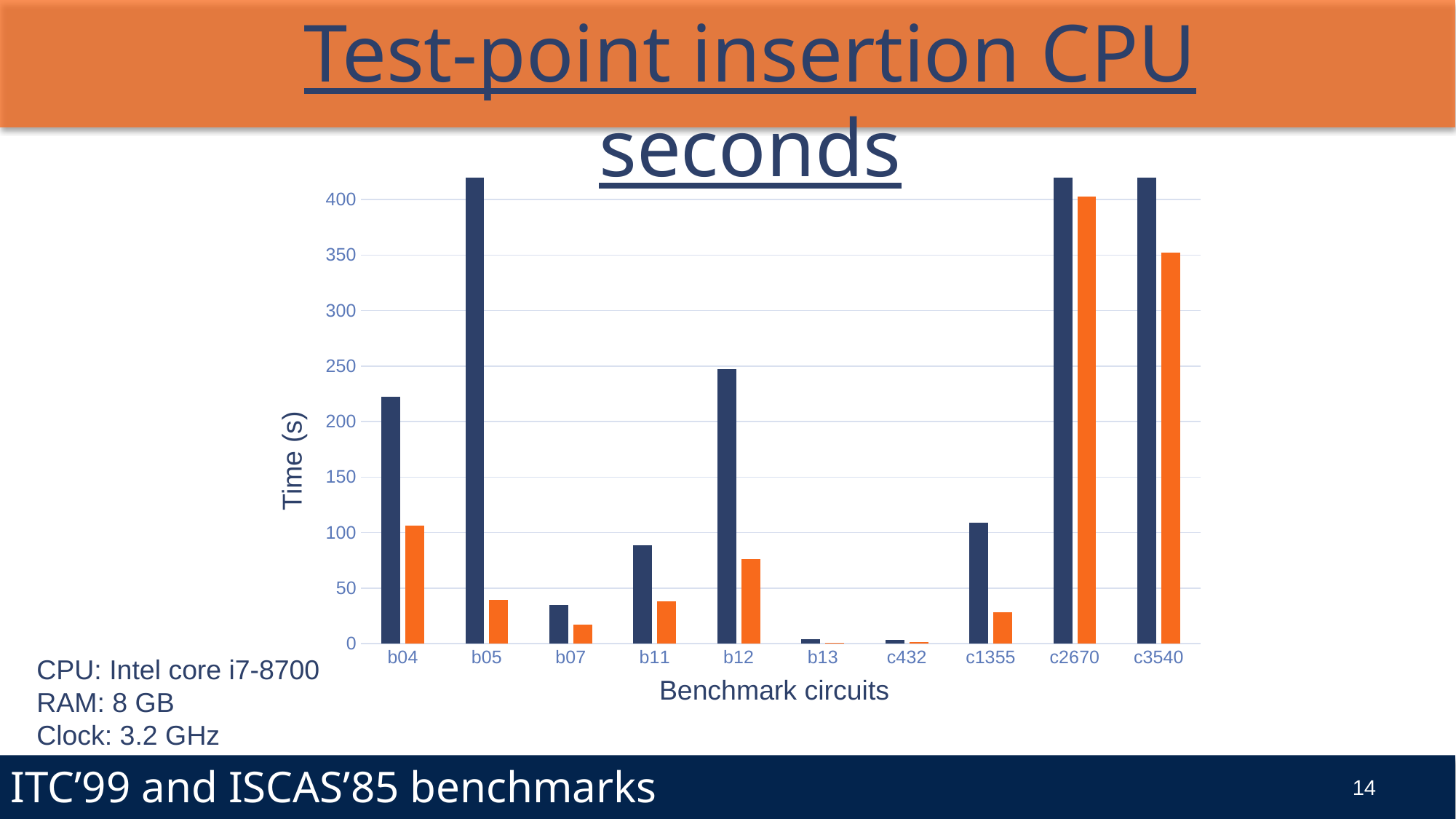
Is the dark blue bar for b11 greater or less than 100? less Which benchmark circuit has the highest orange bar? c2670 For b05, which bar is larger, the dark blue one or the orange one? dark blue Is the orange bar for c3540 greater or less than 300? greater What is the title of the chart? Test-point insertion CPU seconds Which orange bar is larger, c2670 or c3540? c2670 What is the label of the y axis? Time (s) Is the orange bar for c1355 greater or less than 50? less How many benchmark circuits are shown on the x axis? 10 What kind of chart is shown on the slide? bar chart